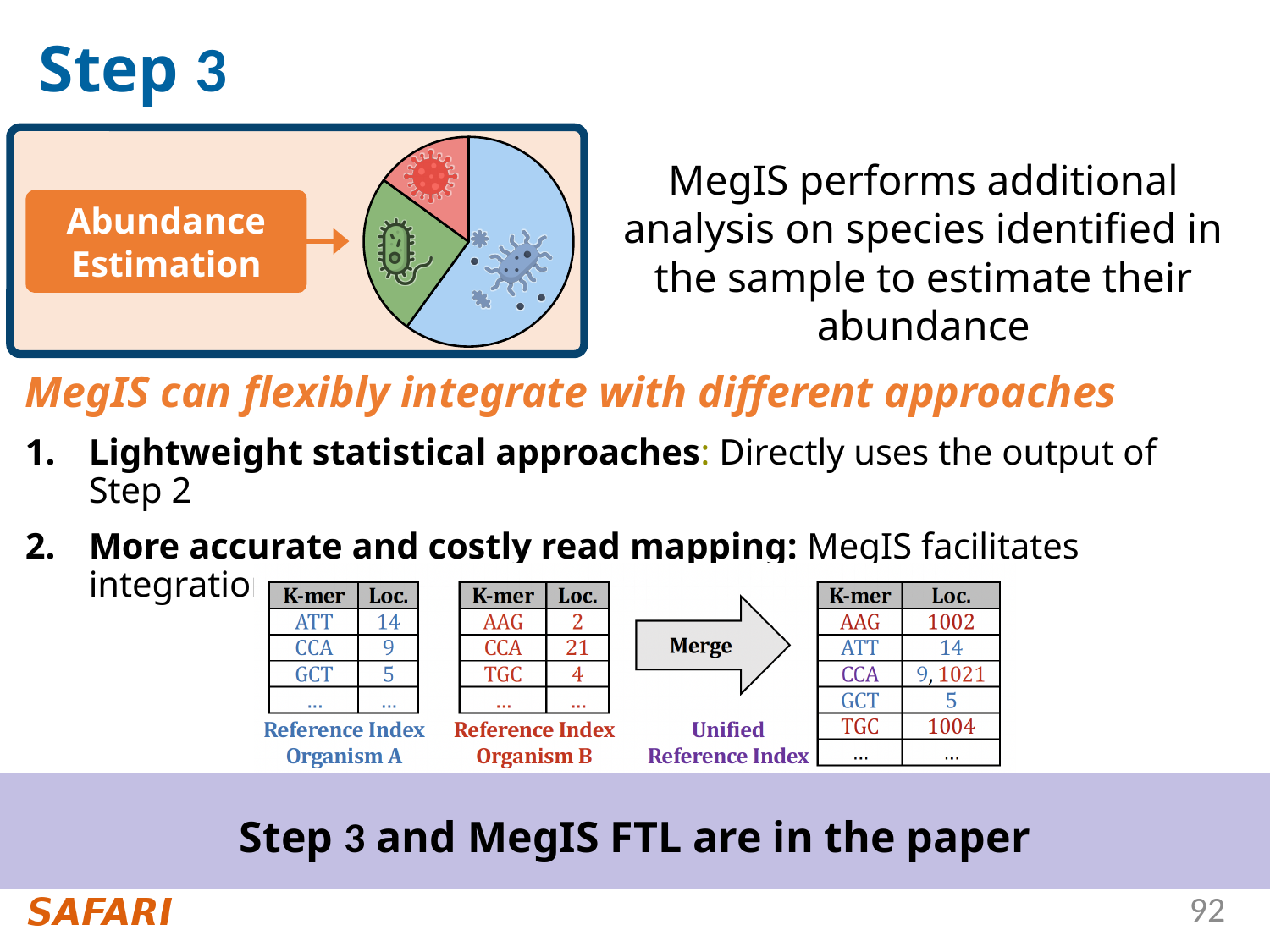
How many slices does the pie chart in the Abundance Estimation box have? 3 In the pie chart in the Abundance Estimation box, is the green slice larger or smaller than the red slice? larger In the pie chart in the Abundance Estimation box, is the green slice larger or smaller than the blue slice? smaller Which colour slice of the pie chart in the Abundance Estimation box is the smallest? red What kind of chart is shown inside the Abundance Estimation box? pie chart Which colour slice of the pie chart in the Abundance Estimation box is the largest? blue Does the pie chart in the Abundance Estimation box show any data labels or percentages? No